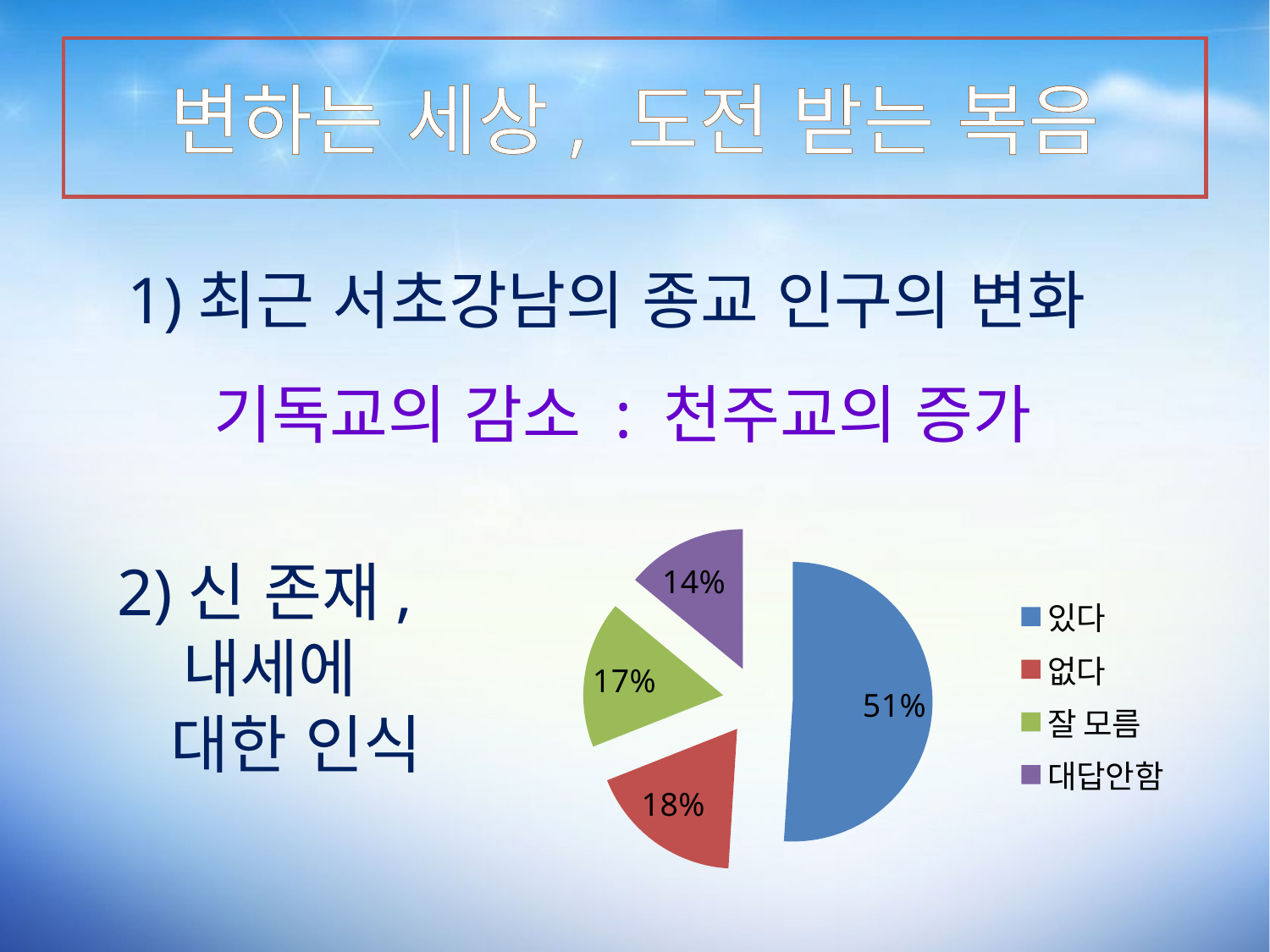
What share of the pie does 있다 have? 51% What share of the pie does 대답안함 have? 14% How many entries does the legend list? 4 Which slice of the pie is the largest? 있다 What share of the pie does 잘 모름 have? 17% Which is larger, the share for 없다 or the share for 대답안함? 없다 What colour is the 있다 slice in the pie chart? blue What is the difference between the share for 있다 and the share for 없다? 33% Which slice of the pie is the smallest? 대답안함 What kind of chart is shown on the slide? pie chart How many slices does the pie chart have? 4